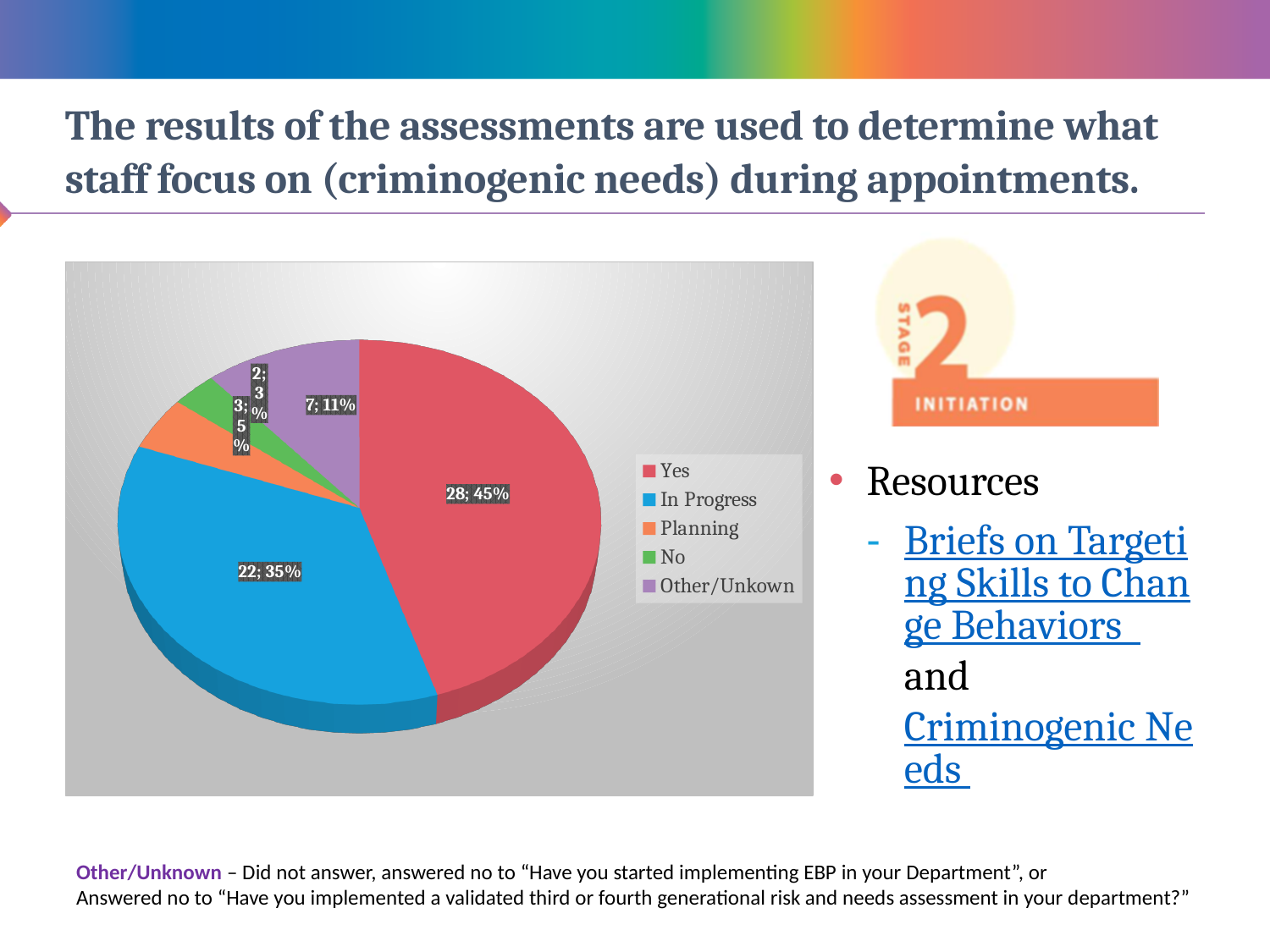
Which category has the largest slice of the pie? Yes What share of the pie does the "No" slice represent? 3% Which category has the smallest slice of the pie? No What count and percentage are shown for the "Yes" slice? 28; 45% What kind of chart is shown on the slide? Pie chart What count and percentage are shown for the "Planning" slice? 3; 5% What count and percentage are shown for the "Other/Unknown" slice? 7; 11% What colour is the "In Progress" slice in the pie chart? Blue Which slice is larger, "Planning" or "Other/Unknown"? Other/Unknown How many categories does the pie chart's legend list? 5 What count and percentage are shown for the "In Progress" slice? 22; 35% What is the difference in count between the "Yes" and "In Progress" slices? 6